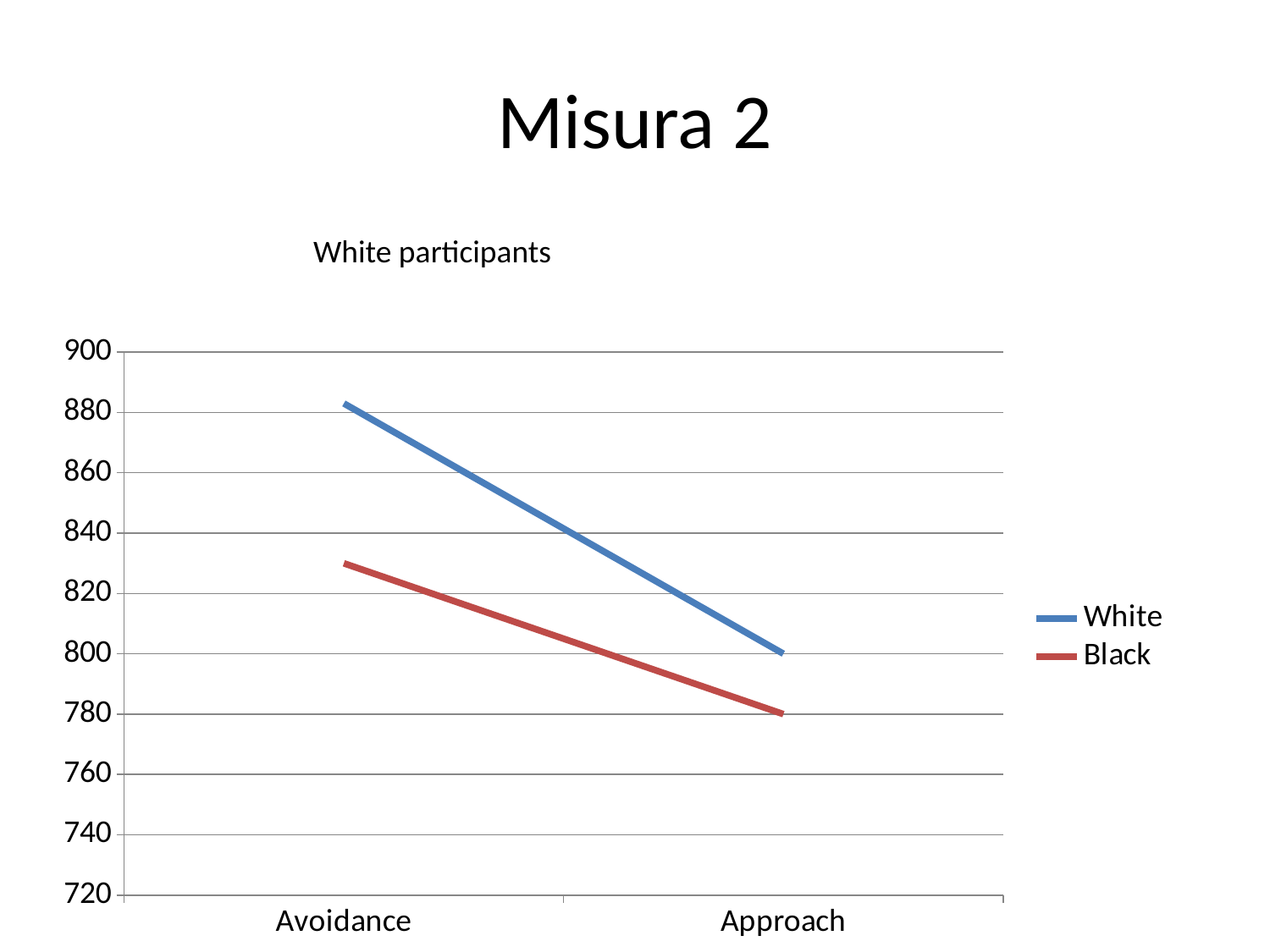
Which series has the higher value at Avoidance, White or Black? White What is the value of the White series at Approach? 800 Is the value of the Black series at Avoidance greater or less than 840? less What is the title of the chart? White participants What kind of chart is shown on the slide? line chart Is the value of the White series at Avoidance greater or less than 860? greater What is the value of the Black series at Approach? 780 How many series does the legend list? 2 Do the values of the White series rise or fall from Avoidance to Approach? fall How many categories are shown on the x axis? 2 Which colour represents the Black series in the legend? red What is the difference between the White and Black values at Approach? 20